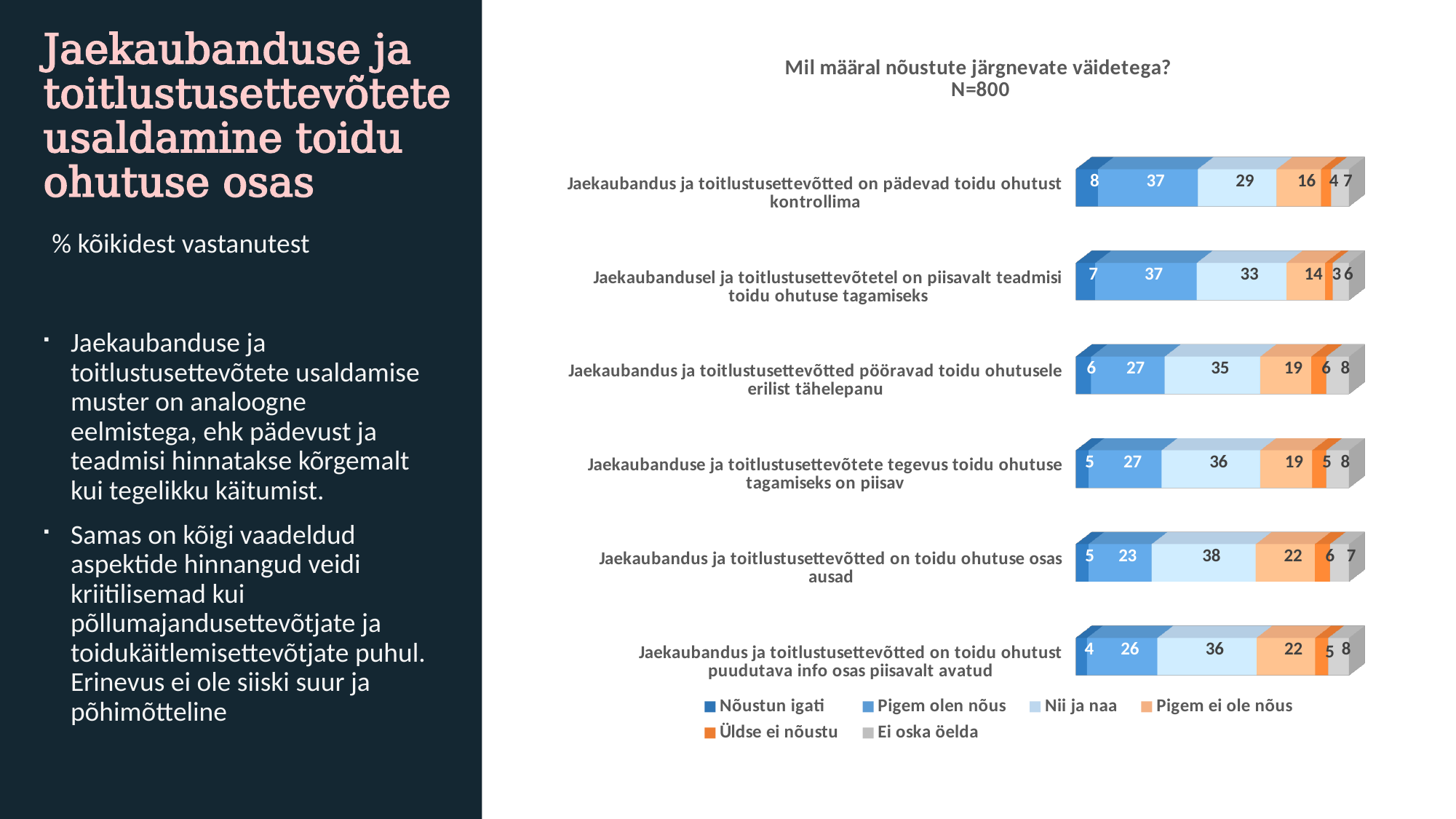
What is the 'Nii ja naa' value for the statement 'Jaekaubandus ja toitlustusettevõtted on toidu ohutuse osas ausad'? 38 What kind of chart is shown on the slide? Stacked bar chart What is the 'Pigem ei ole nõus' value for the statement 'Jaekaubandusel ja toitlustusettevõtetel on piisavalt teadmisi toidu ohutuse tagamiseks'? 14 What is the difference between the 'Nii ja naa' values for 'Jaekaubandus ja toitlustusettevõtted on toidu ohutuse osas ausad' and 'Jaekaubandus ja toitlustusettevõtted on pädevad toidu ohutust kontrollima'? 9 Which statement has the lowest 'Nõustun igati' value? Jaekaubandus ja toitlustusettevõtted on toidu ohutust puudutava info osas piisavalt avatud Which is larger: the 'Pigem ei ole nõus' value for 'Jaekaubandus ja toitlustusettevõtted pööravad toidu ohutusele erilist tähelepanu' or for 'Jaekaubandus ja toitlustusettevõtted on toidu ohutuse osas ausad'? Jaekaubandus ja toitlustusettevõtted on toidu ohutuse osas ausad What is the sample size (N) stated in the chart title? N=800 How many series does the legend list? 6 What is the 'Pigem olen nõus' value for the statement 'Jaekaubandus ja toitlustusettevõtted on pädevad toidu ohutust kontrollima'? 37 Which statement has the highest 'Nõustun igati' value? Jaekaubandus ja toitlustusettevõtted on pädevad toidu ohutust kontrollima Which legend entry is shown in dark orange? Üldse ei nõustu How many statements (categories) are plotted in the chart? 6